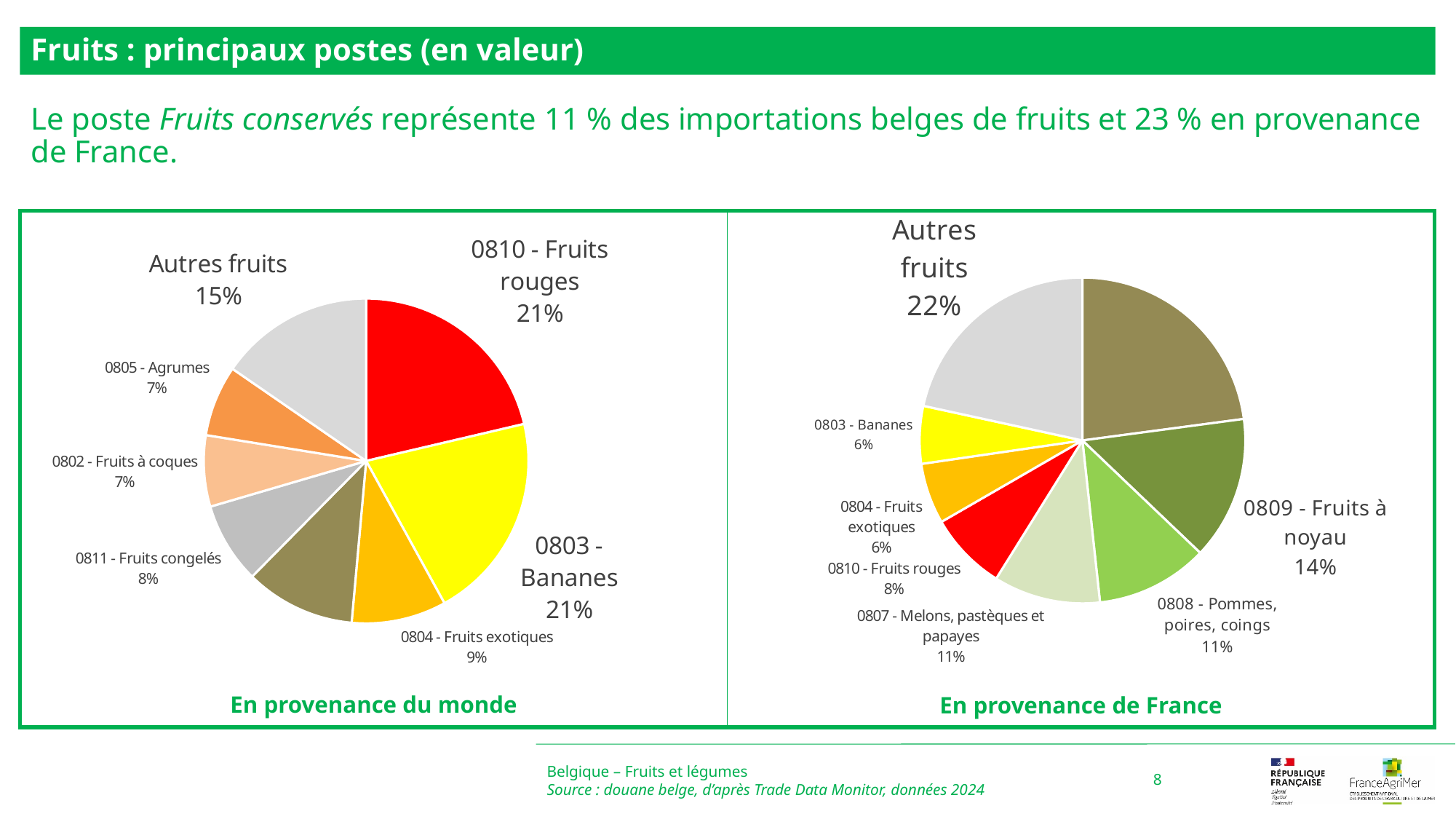
What kind of chart is used for 'En provenance de France'? Pie chart In the pie chart 'En provenance de France', which is larger: the share of 0809 - Fruits à noyau or the share of 0803 - Bananes? 0809 - Fruits à noyau In the pie chart 'En provenance de France', what share is shown for 0810 - Fruits rouges? 8% In the pie chart 'En provenance de France', what share is shown for Autres fruits? 22% In the pie chart 'En provenance du monde', what share is shown for Autres fruits? 15% In the pie chart 'En provenance du monde', what share is shown for 0810 - Fruits rouges? 21% In the pie chart 'En provenance du monde', what share is shown for 0804 - Fruits exotiques? 9% In the pie chart 'En provenance de France', what share is shown for 0807 - Melons, pastèques et papayes? 11% In the pie chart 'En provenance de France', what share is shown for 0809 - Fruits à noyau? 14% In the pie chart 'En provenance du monde', what is the difference between the shares of 0803 - Bananes and 0804 - Fruits exotiques? 12 percentage points In the pie chart 'En provenance du monde', what share is shown for 0811 - Fruits congelés? 8% What is the title of the slide? Fruits : principaux postes (en valeur)